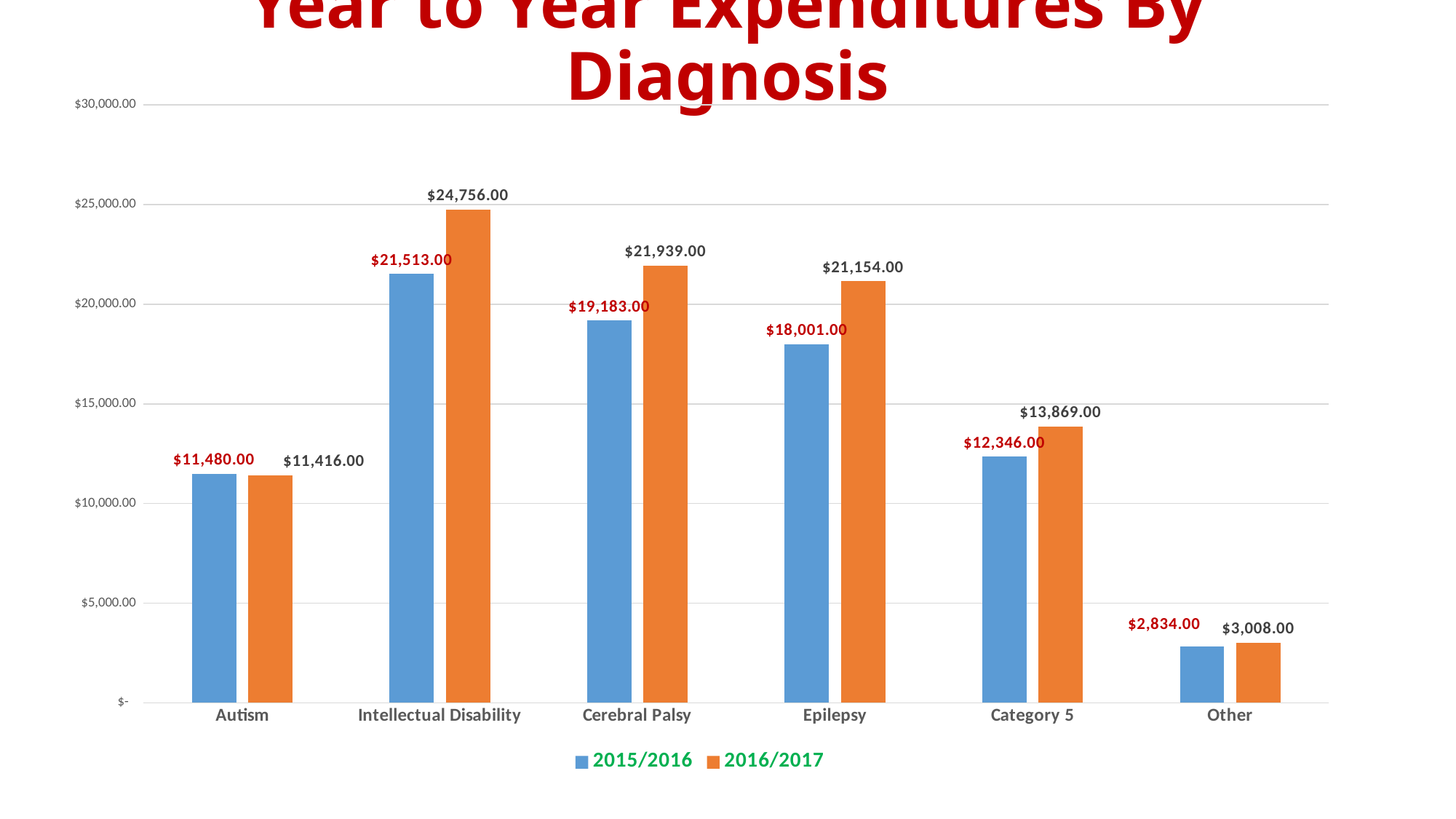
Which is larger for Autism: the 2015/2016 expenditure or the 2016/2017 expenditure? 2015/2016 What was the 2015/2016 expenditure for Other? $2,834.00 Which colour represents the 2016/2017 series? Orange What kind of chart is shown on the slide? Bar chart What is the difference between the 2016/2017 and 2015/2016 expenditures for Category 5? $1,523.00 Which diagnosis had the lowest 2015/2016 expenditure? Other How many series does the legend list? 2 What was the 2015/2016 expenditure for Epilepsy? $18,001.00 Is the 2016/2017 expenditure for Cerebral Palsy greater or less than $20,000.00? greater How many diagnosis categories are shown on the x axis? 6 Which diagnosis had the highest 2016/2017 expenditure? Intellectual Disability What was the 2016/2017 expenditure for Intellectual Disability? $24,756.00